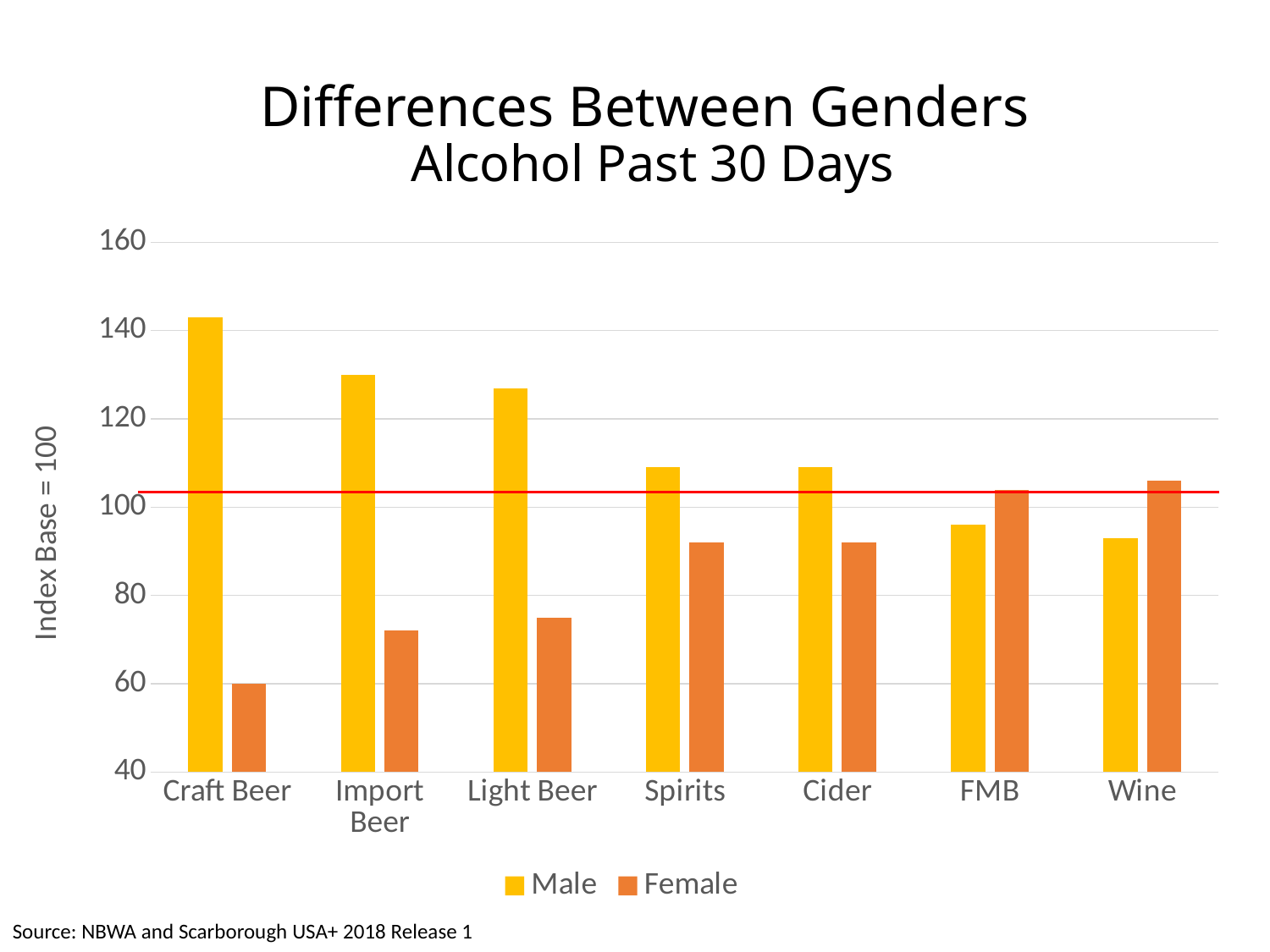
Which is larger for Light Beer, the Male value or the Female value? Male Is the Male value for Craft Beer greater or less than 140? greater Is the Female value for Spirits greater or less than 100? less Which category has the highest Male value? Craft Beer How many series does the legend list? 2 What kind of chart is shown on the slide? bar chart Which category has the lowest Female value? Craft Beer How many categories are shown on the x axis? 7 Is the Male value for Wine greater or less than 100? less Do the Female values generally rise or fall from Craft Beer to Wine along the x axis? rise Which is larger for Wine, the Male value or the Female value? Female